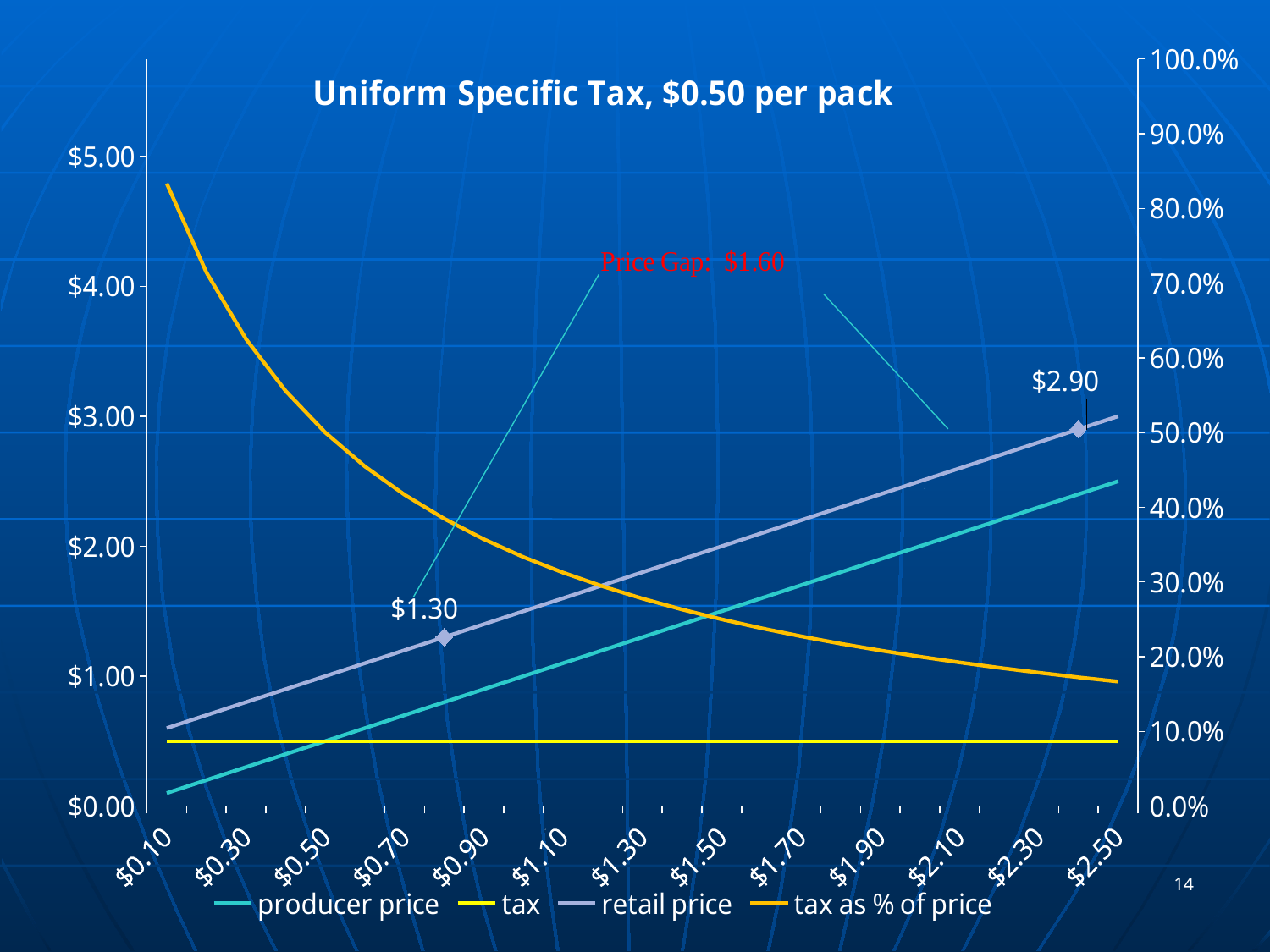
At $2.50 on the x axis, which is larger, the retail price or the producer price? retail price At $2.50 on the x axis, is the tax as % of price greater or less than 20.0%? less Is the value of the tax series greater or less than $1.00? less How many series does the legend list? 4 What is the difference between the two labeled retail price values, $2.90 and $1.30? $1.60 Does the retail price series rise or fall as the x axis increases? rise What kind of chart is shown on the slide? line chart Does the tax as % of price series rise or fall as the x axis increases? fall What is the title of the chart? Uniform Specific Tax, $0.50 per pack What is the higher of the two labeled values on the retail price line? $2.90 What is the lower of the two labeled values on the retail price line? $1.30 What price gap value is annotated on the chart? $1.60